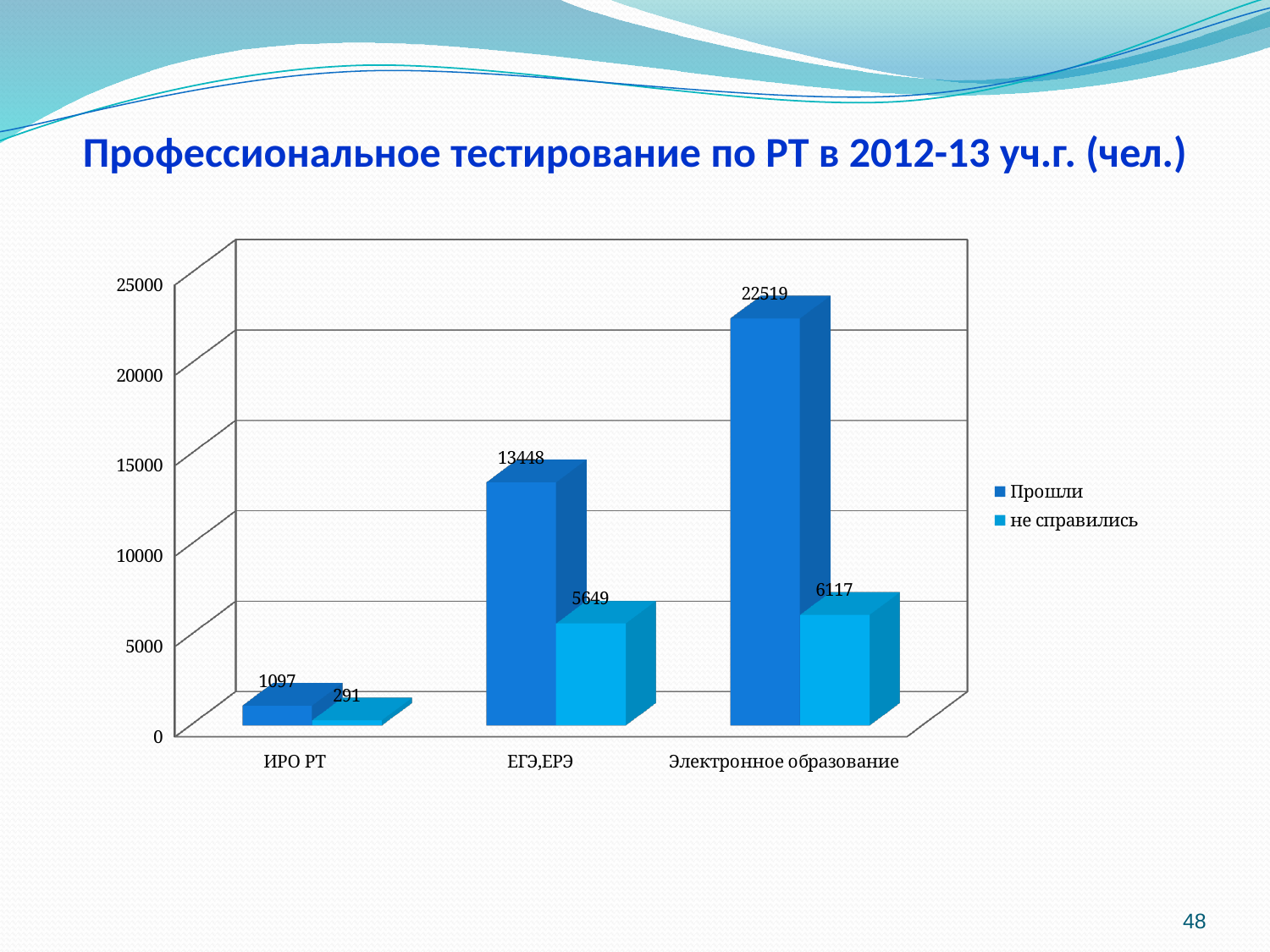
Is the value for "Прошли" in "Электронное образование" greater or less than 20000? greater What kind of chart is shown on the slide? bar chart Which is larger: "не справились" for "ЕГЭ,ЕРЭ" or "не справились" for "Электронное образование"? Электронное образование What is the difference between "Прошли" and "не справились" in the "Электронное образование" category? 16402 What is the value for "Прошли" in the "ЕГЭ,ЕРЭ" category? 13448 How many categories are shown on the x axis? 3 What is the value for "не справились" in the "Электронное образование" category? 6117 Which category has the highest value for "Прошли"? Электронное образование What is the title of the chart? Профессиональное тестирование по РТ в 2012-13 уч.г. (чел.) What is the value for "не справились" in the "ИРО РТ" category? 291 Which category has the lowest value for "не справились"? ИРО РТ How many series does the legend list? 2